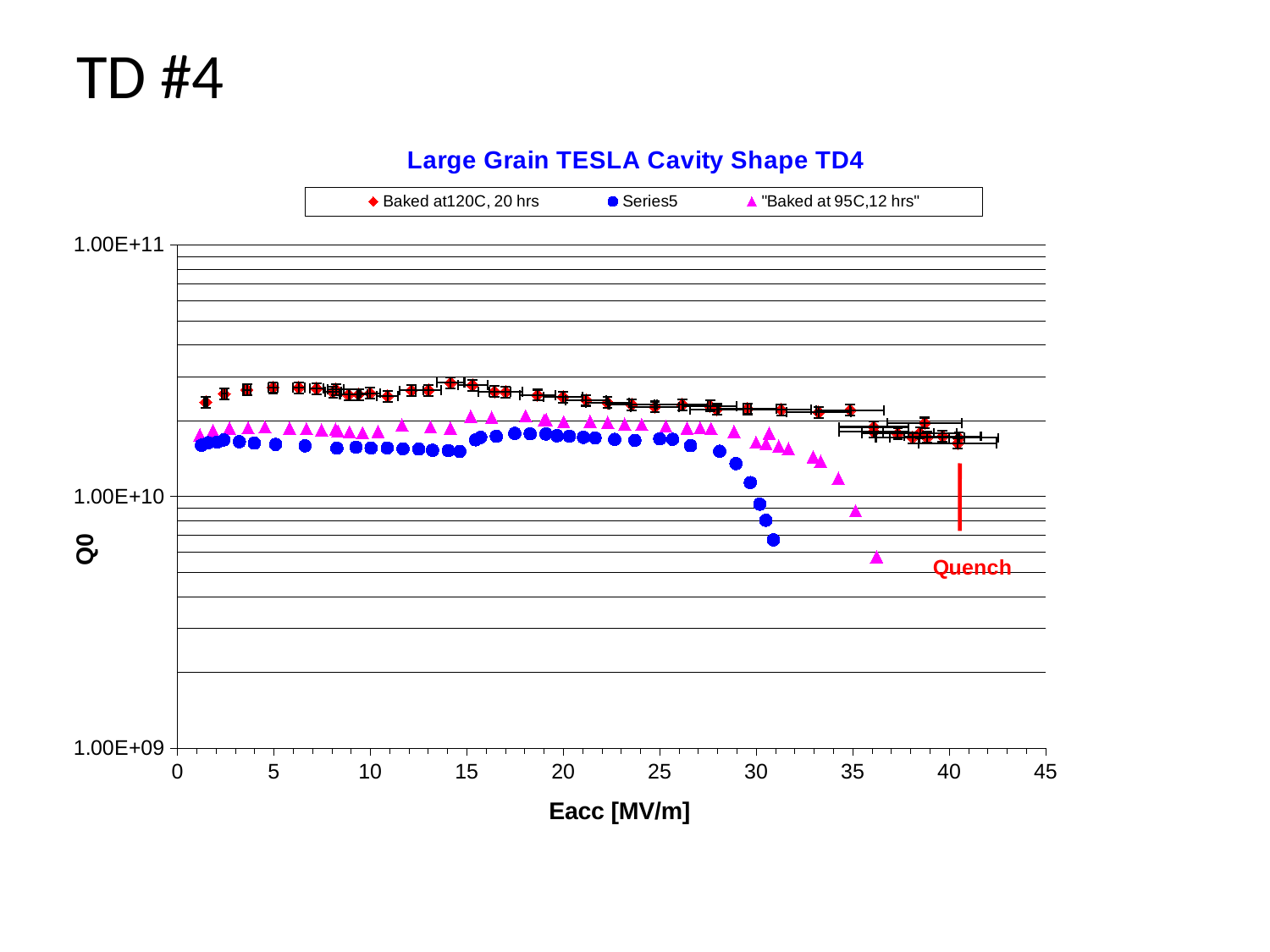
Does the Q0 of the 'Baked at120C, 20 hrs' series rise or fall as Eacc increases from 15 to 40 MV/m? fall What is the label of the x axis? Eacc [MV/m] Which series ends at the lowest Eacc? Series5 At Eacc = 10 MV/m, which series has the higher Q0: 'Baked at120C, 20 hrs' or Series5? Baked at120C, 20 hrs What kind of chart is shown on the slide? scatter chart What is the title of the chart? Large Grain TESLA Cavity Shape TD4 Which series reaches the highest Eacc before ending? Baked at120C, 20 hrs Is the Q0 value of the last Series5 point (near Eacc = 31 MV/m) greater or less than 1.00E+10? less Does the Q0 of Series5 rise or fall as Eacc increases from 28 to 31 MV/m? fall Is the Q0 value of the last 'Baked at 95C,12 hrs' point (near Eacc = 36 MV/m) greater or less than 1.00E+10? less How many series does the legend list? 3 Is the Q0 value for the 'Baked at120C, 20 hrs' series at Eacc = 5 MV/m greater or less than 1.00E+10? greater